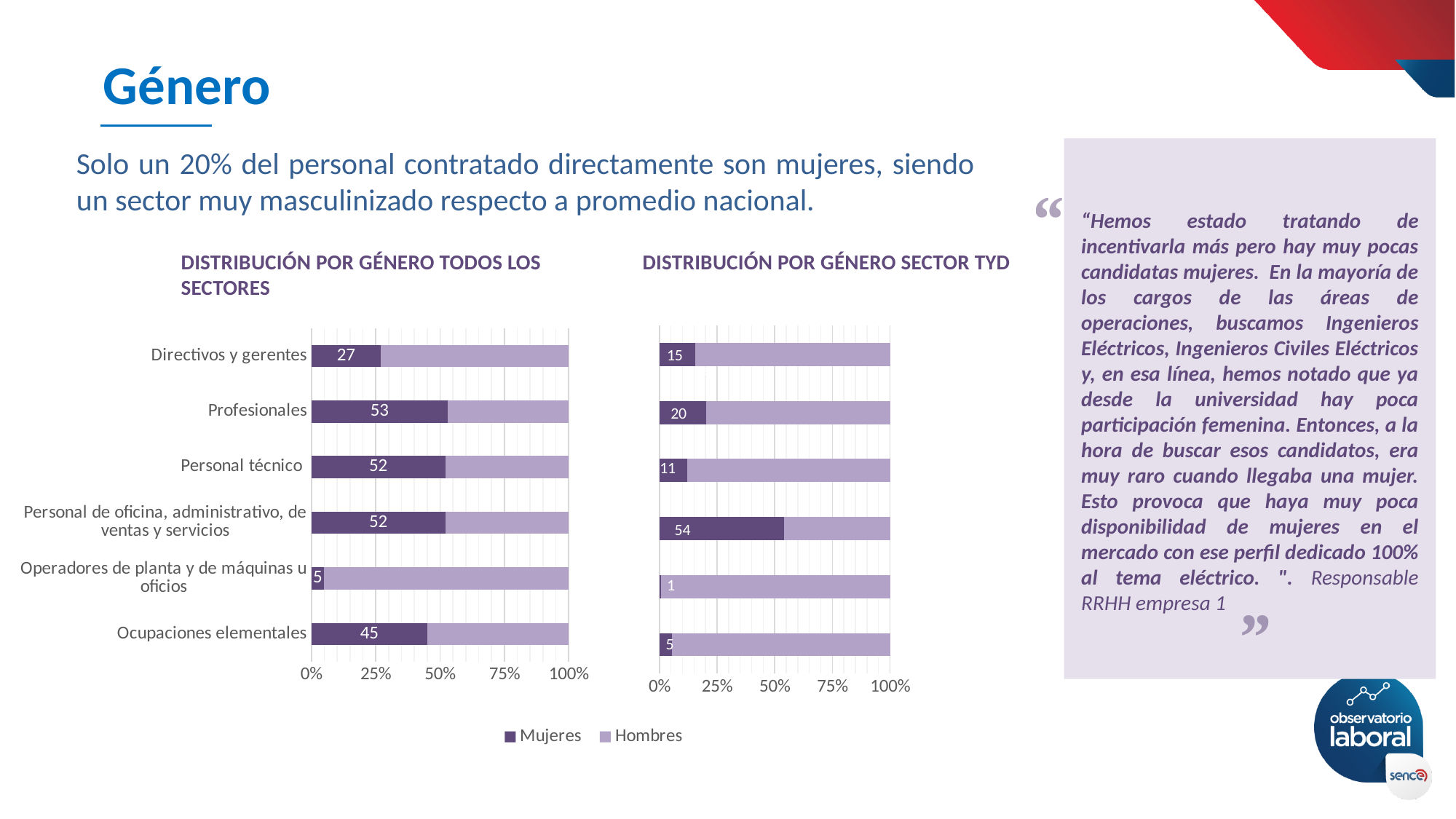
How many series does the legend list for the gender distribution charts? 2 In the chart 'DISTRIBUCIÓN POR GÉNERO SECTOR TYD', which category has the highest Mujeres value? Personal de oficina, administrativo, de ventas y servicios How many occupational categories are shown in the chart 'DISTRIBUCIÓN POR GÉNERO TODOS LOS SECTORES'? 6 In the chart 'DISTRIBUCIÓN POR GÉNERO SECTOR TYD', is the Hombres share for Personal técnico greater or less than 75%? greater In the chart 'DISTRIBUCIÓN POR GÉNERO TODOS LOS SECTORES', which category has the highest Mujeres value? Profesionales In the chart 'DISTRIBUCIÓN POR GÉNERO TODOS LOS SECTORES', what is the Mujeres value for Directivos y gerentes? 27 In the chart 'DISTRIBUCIÓN POR GÉNERO SECTOR TYD', what is the Mujeres value for Personal de oficina, administrativo, de ventas y servicios? 54 What type of chart is 'DISTRIBUCIÓN POR GÉNERO SECTOR TYD'? Stacked bar chart In the chart 'DISTRIBUCIÓN POR GÉNERO TODOS LOS SECTORES', which is larger, the Mujeres value for Ocupaciones elementales or for Directivos y gerentes? Ocupaciones elementales What is the difference between the Mujeres value for Directivos y gerentes in the 'TODOS LOS SECTORES' chart and in the 'SECTOR TYD' chart? 12 In the chart 'DISTRIBUCIÓN POR GÉNERO SECTOR TYD', which category has the lowest Mujeres value? Operadores de planta y de máquinas u oficios In the chart 'DISTRIBUCIÓN POR GÉNERO SECTOR TYD', what is the Mujeres value for Profesionales? 20